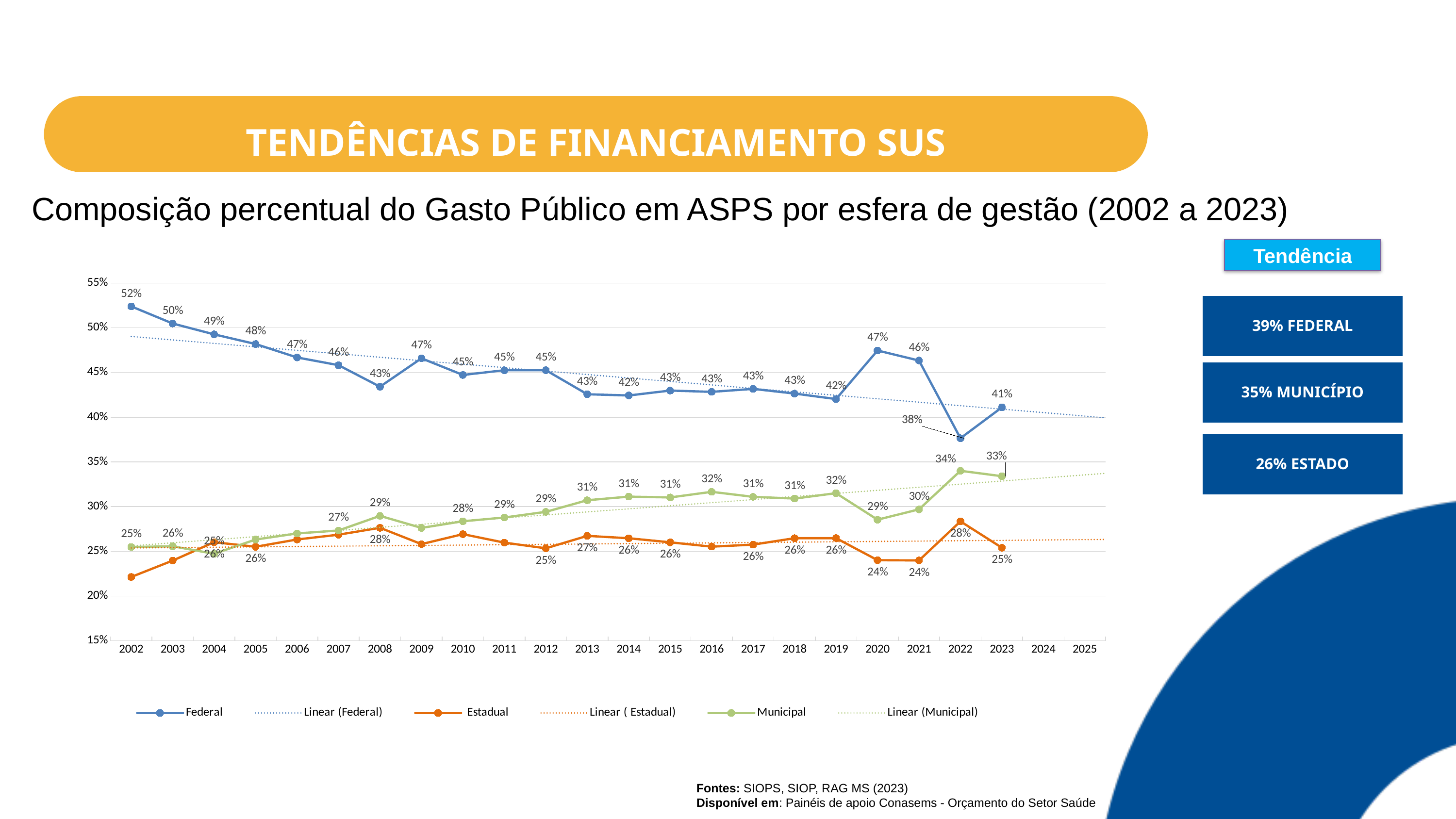
In 2023, which is larger, the Municipal share or the Estadual share? Municipal What kind of chart is shown on the slide? Line chart What is the Federal share in 2002? 52% By how many percentage points did the Federal share fall from 2002 to 2023? 11 percentage points What is the Municipal share in 2022? 34% In which year is the Federal share highest? 2002 Is the Estadual value for 2002 greater or less than 25%? less Does the Federal series generally rise or fall from 2002 to 2023? Fall What is the Estadual share in 2020? 24% In which year is the Federal share lowest? 2022 What is the Federal share in 2023? 41% How many entries does the chart legend list? 6